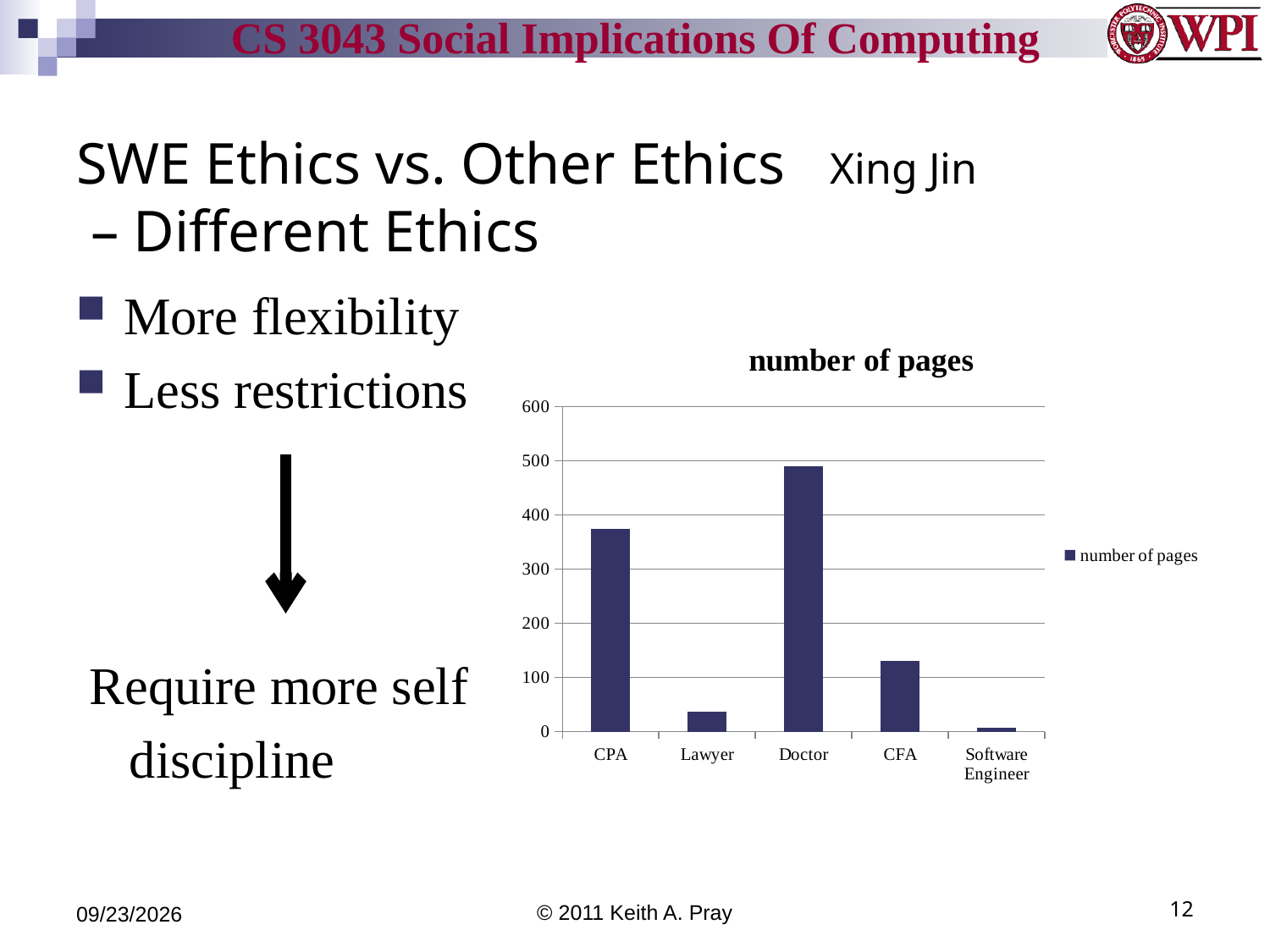
How many categories are shown on the x axis of the chart? 5 Is the value for Lawyer greater or less than 100? less Which category has the lowest number of pages? Software Engineer Which has more pages, Lawyer or Software Engineer? Lawyer How many series does the chart legend list? 1 What is the title of the chart? number of pages Is the value for CFA greater or less than 100? greater What kind of chart is shown on the slide? bar chart Which has more pages, CPA or CFA? CPA Is the value for CPA greater or less than 300? greater Which category has the highest number of pages? Doctor